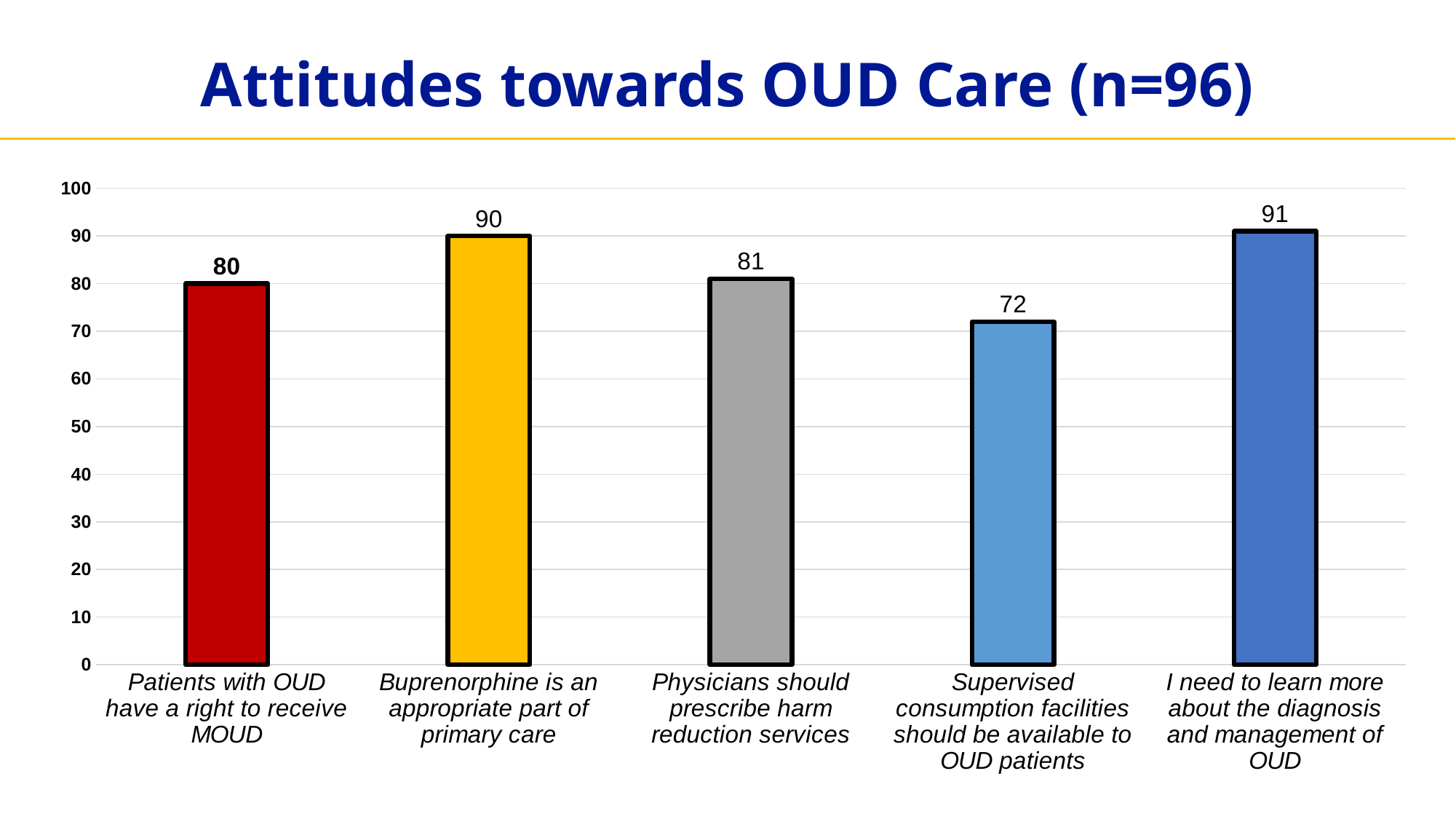
What is the value for "I need to learn more about the diagnosis and management of OUD"? 91 What is the difference between the values for "Buprenorphine is an appropriate part of primary care" and "Supervised consumption facilities should be available to OUD patients"? 18 Which category has the highest value? I need to learn more about the diagnosis and management of OUD How many categories are shown in the chart? 5 What is the value for "Supervised consumption facilities should be available to OUD patients"? 72 What is the value for "Patients with OUD have a right to receive MOUD"? 80 What is the value for "Buprenorphine is an appropriate part of primary care"? 90 Which category has the lowest value? Supervised consumption facilities should be available to OUD patients Which is larger: the value for "Physicians should prescribe harm reduction services" or the value for "Patients with OUD have a right to receive MOUD"? Physicians should prescribe harm reduction services What kind of chart is shown on the slide? bar chart Is the value for "Physicians should prescribe harm reduction services" greater or less than 70? greater What is the title of the chart? Attitudes towards OUD Care (n=96)